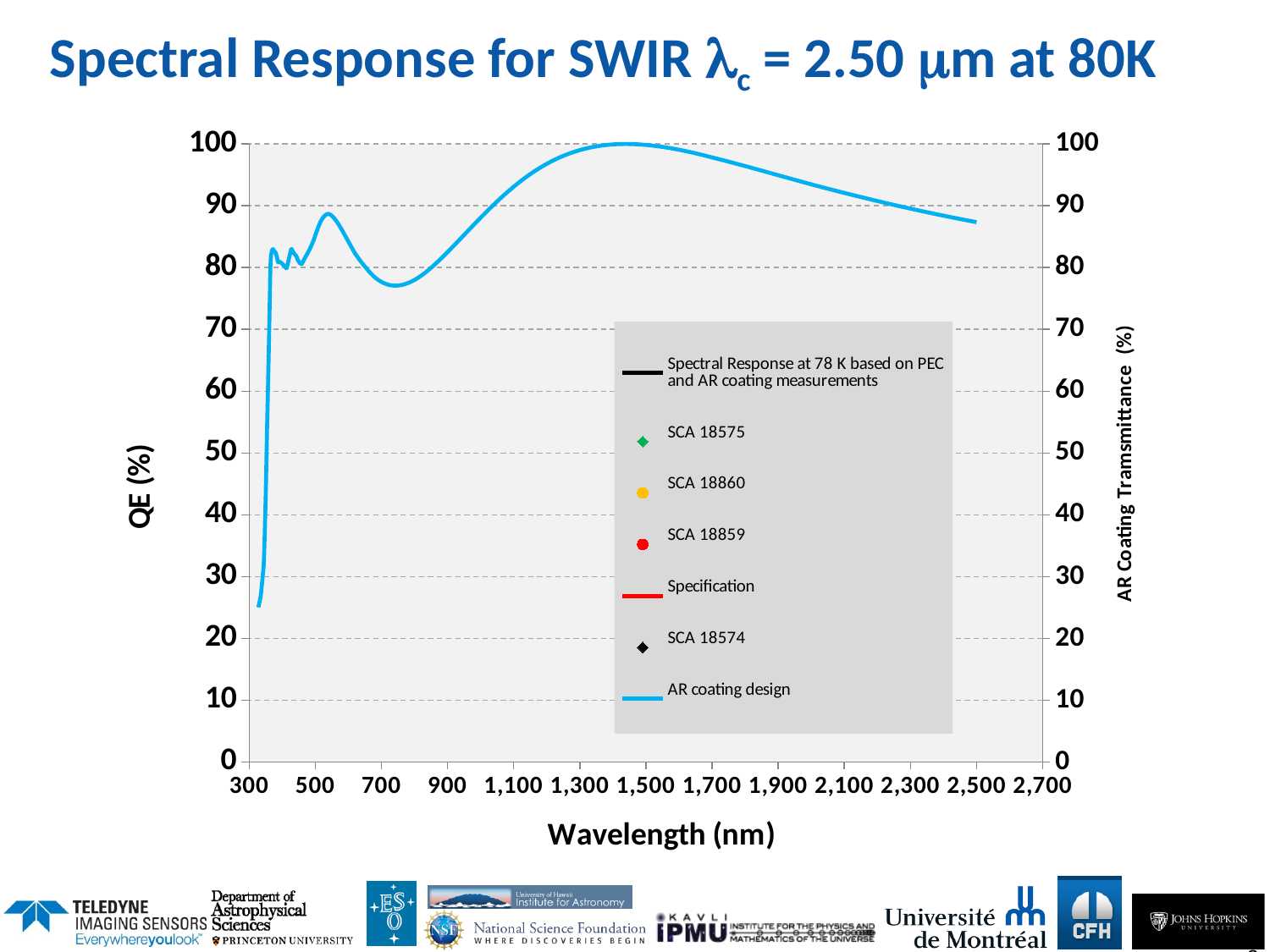
How many entries does the chart legend list? 7 What kind of chart is shown on the slide? line chart What is the label of the x axis? Wavelength (nm) What is the title of the chart on the slide? Spectral Response for SWIR λc = 2.50 μm at 80K Does the AR coating design curve rise or fall between 1,500 nm and 2,500 nm? fall Is the AR coating design value at 900 nm greater or less than 90? less Does the AR coating design curve rise or fall between 900 nm and 1,300 nm? rise Is the AR coating design value at 2,500 nm greater or less than 90? less Which is larger for the AR coating design curve: the value at 1,500 nm or the value at 2,500 nm? 1,500 nm Is the AR coating design value at 1,500 nm greater or less than 90? greater